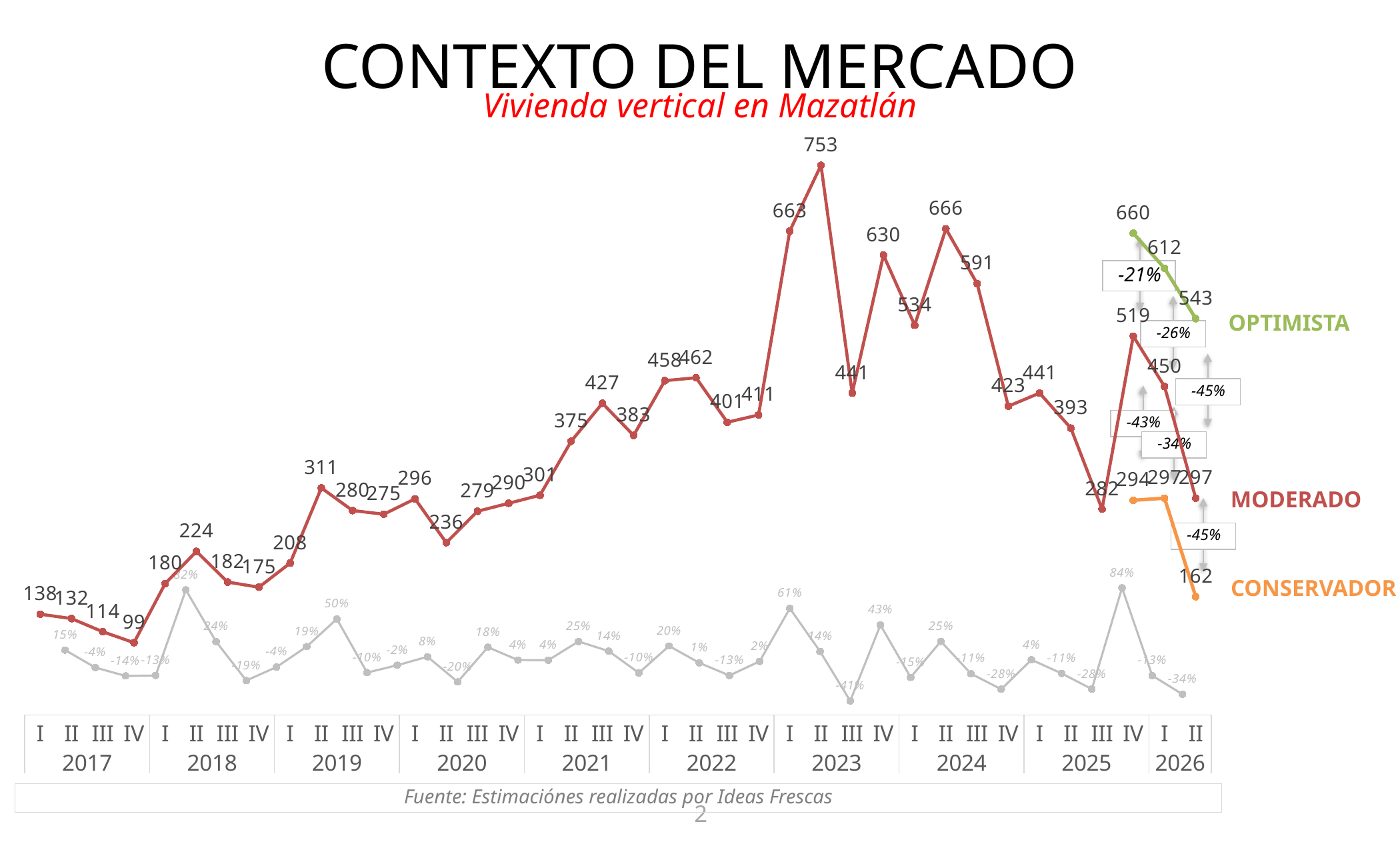
What is the lowest value on the main red line, and in which quarter does it occur? 99, in 2017 IV Which is larger, the value for 2023 II or the value for 2024 II? 2023 II What is the difference between the values for 2023 II and 2023 I? 90 What is the CONSERVADOR scenario value for quarter II of 2026? 162 Do the values on the red line rise or fall from quarter I to quarter IV of 2017? Fall What are the names of the three scenarios labelled at the right of the chart? OPTIMISTA, MODERADO, CONSERVADOR What is the value for quarter I of 2023 on the red line? 663 What is the highest value on the main red line, and in which quarter does it occur? 753, in 2023 II What kind of chart is shown on the slide? Line chart What is the difference between the OPTIMISTA and CONSERVADOR values for quarter II of 2026? 381 What is the OPTIMISTA scenario value for quarter II of 2026? 543 What is the value for quarter II of 2024 on the red line? 666